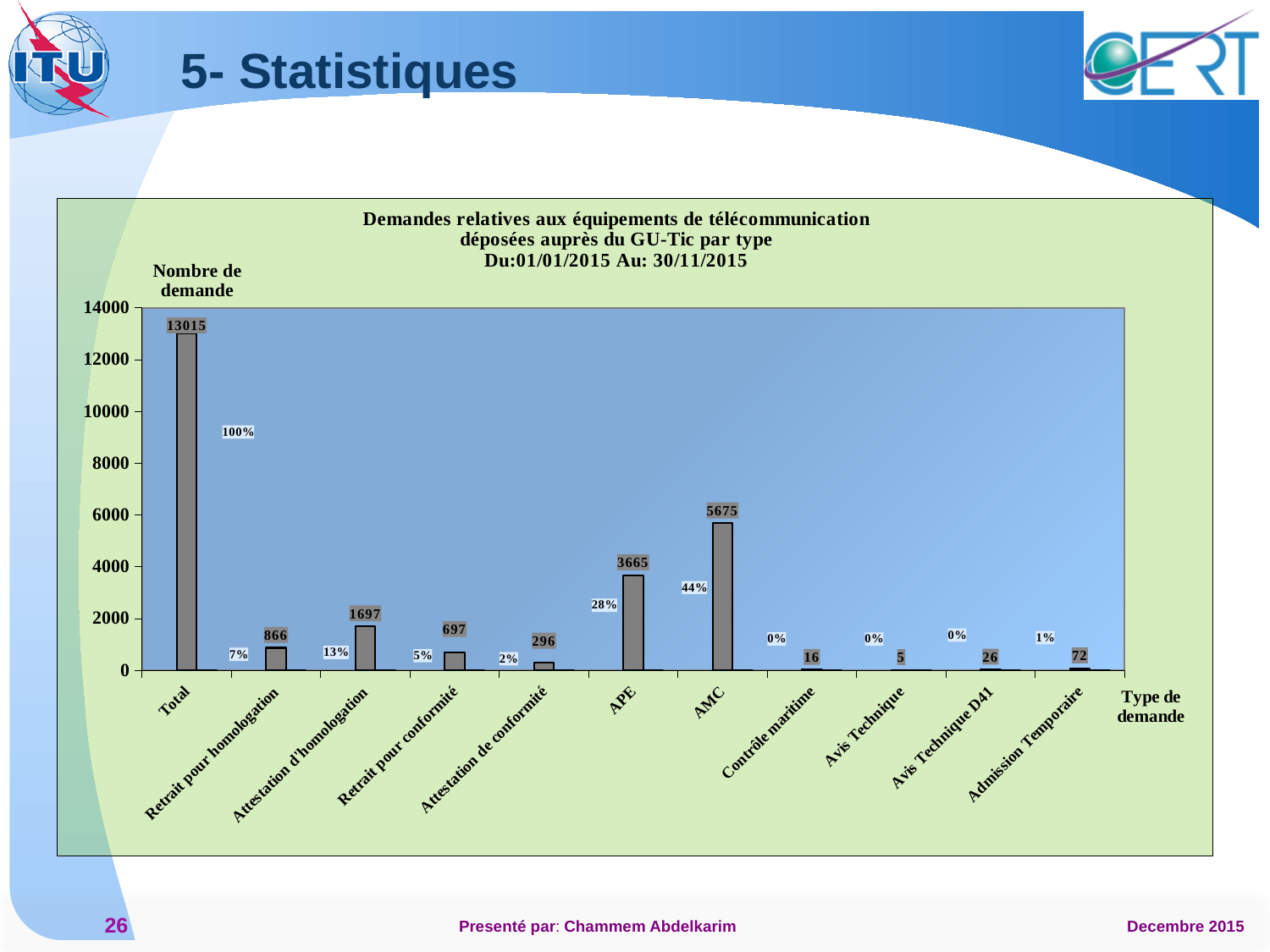
How many categories are shown on the x axis? 11 Which has more requests, Retrait pour conformité or Attestation de conformité? Retrait pour conformité What is the number of requests for AMC? 5675 What percentage is shown for Retrait pour homologation? 7% What kind of chart is shown on the slide? bar chart What is the difference between the number of requests for AMC and APE? 2010 What is the value shown for Admission Temporaire? 72 What is the number of requests for APE? 3665 Excluding the Total bar, which type of request has the highest number? AMC Which type of request has the lowest number? Avis Technique Is the value for Attestation d'homologation greater or less than 2000? less What is the number of requests for Attestation d'homologation? 1697